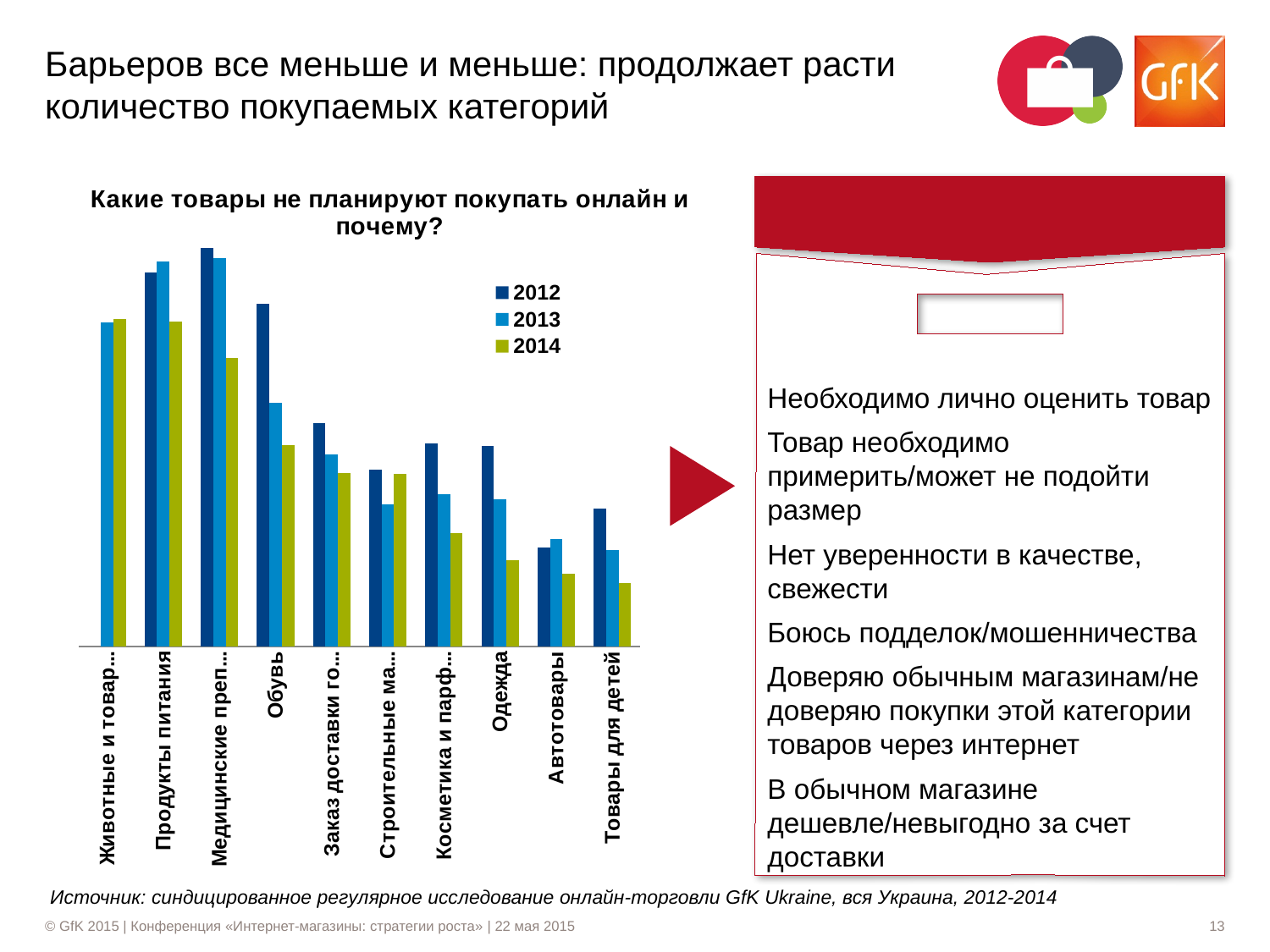
What is the title of the chart? Какие товары не планируют покупать онлайн и почему? Which category has the lowest 2012 value in the chart? Автотовары Which is larger in 2012: Одежда or Автотовары? Одежда For Медицинские преп..., which is larger: the 2013 value or the 2014 value? 2013 What kind of chart is shown on the slide? bar chart Do the values for Медицинские преп... rise or fall from 2012 to 2014? fall How many series does the legend of the chart list? 3 For Обувь, which is larger: the 2012 value or the 2014 value? 2012 Do the values for Обувь rise or fall from 2012 to 2014? fall How many product categories are shown on the x axis of the chart? 10 Which category has the highest 2012 value in the chart? Медицинские преп... Which years are listed in the chart's legend? 2012, 2013, 2014